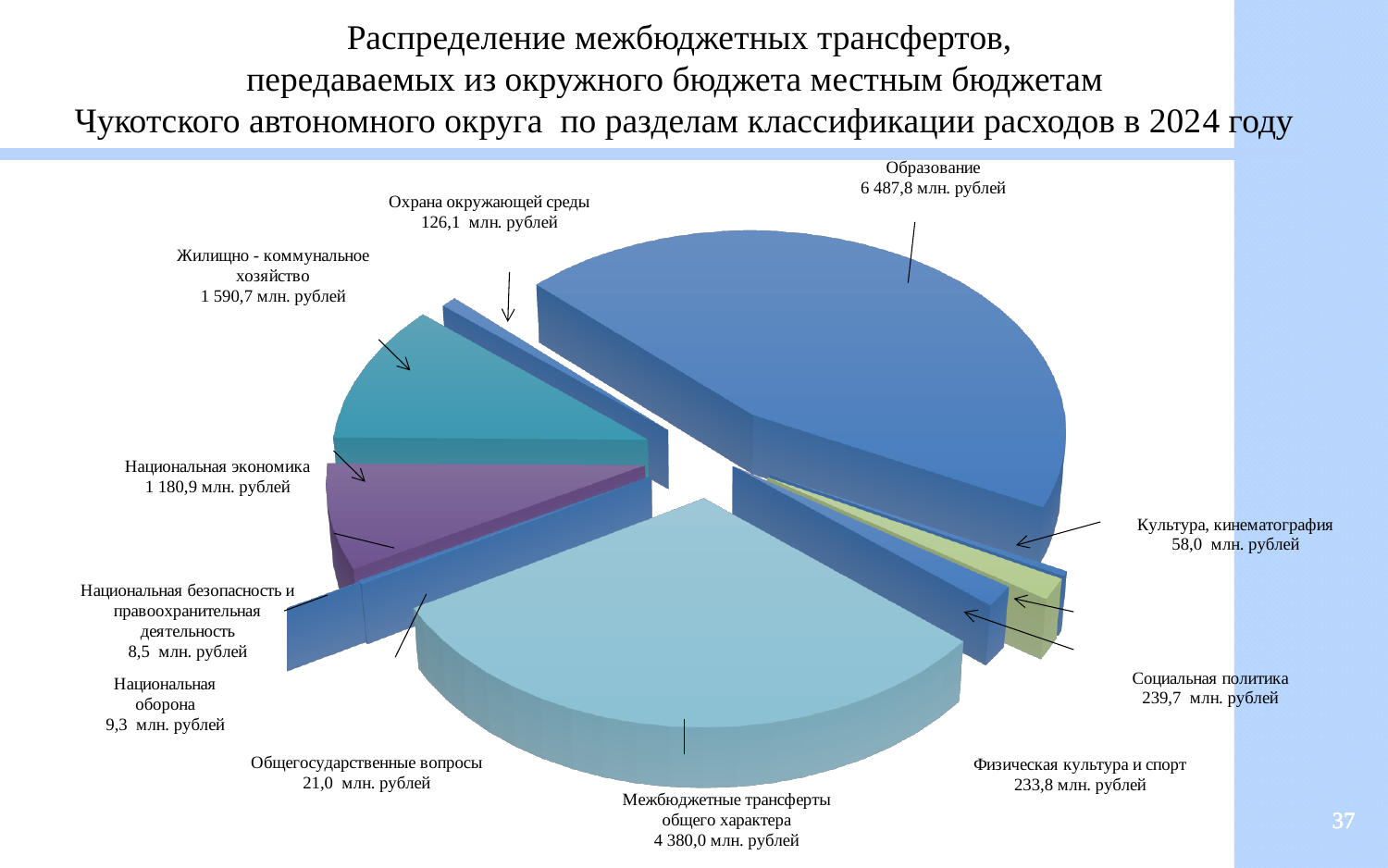
How many categories does the pie chart show? 11 Which category has the largest value? Образование What is the value for Жилищно-коммунальное хозяйство? 1 590,7 млн. рублей What is the value for Межбюджетные трансферты общего характера? 4 380,0 млн. рублей What is the value for Культура, кинематография? 58,0 млн. рублей What kind of chart is shown on the slide? Pie chart What is the difference between Образование and Межбюджетные трансферты общего характера? 2 107,8 млн. рублей Which year does the chart title refer to? 2024 What is the difference between Жилищно-коммунальное хозяйство and Национальная экономика? 409,8 млн. рублей Which is larger: Социальная политика or Физическая культура и спорт? Социальная политика What is the value for Образование? 6 487,8 млн. рублей Which category has the smallest value? Национальная безопасность и правоохранительная деятельность